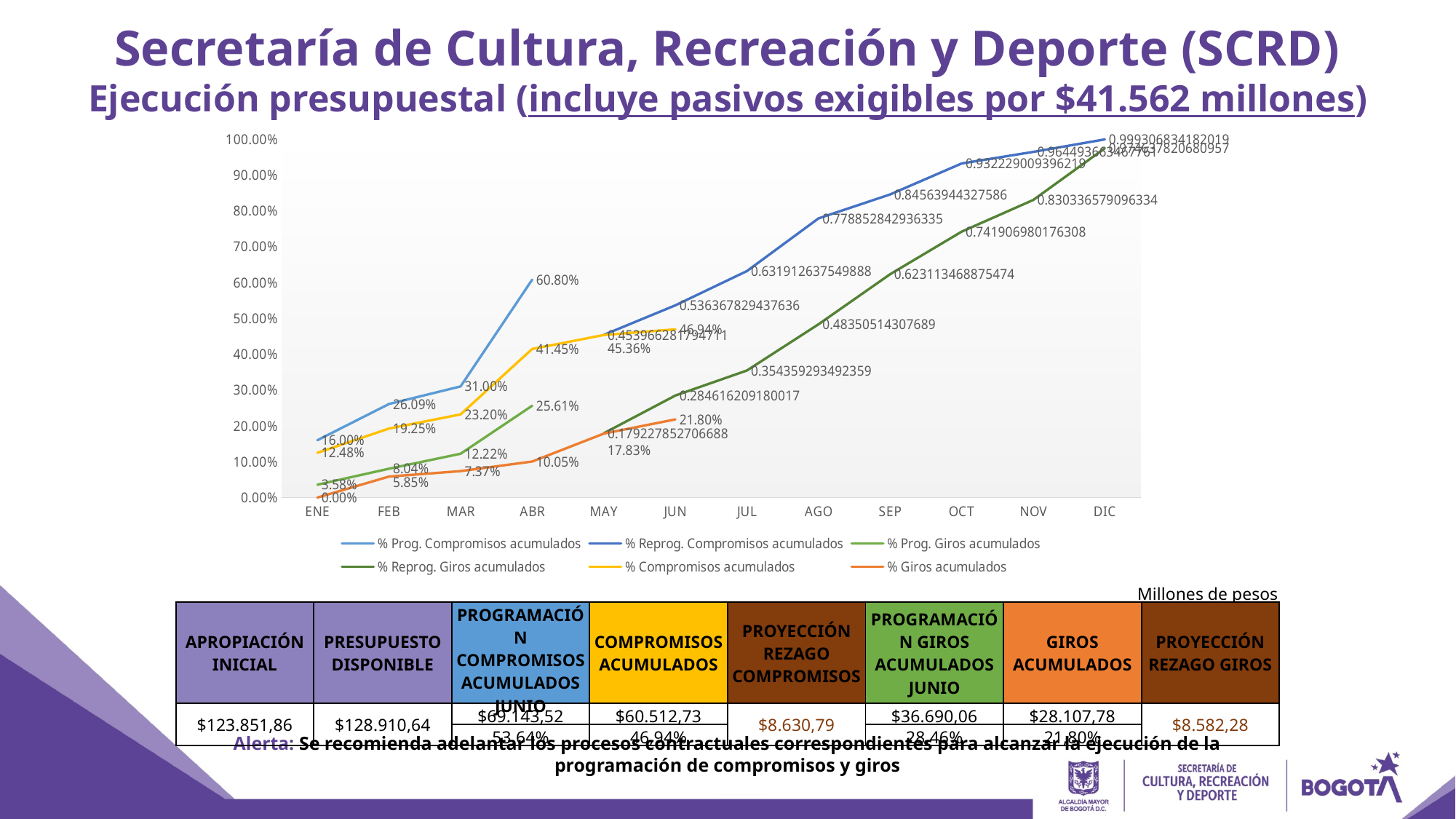
What is the value of % Compromisos acumulados in JUN? 46.94% Does % Compromisos acumulados rise or fall from ENE to JUN? Rise What is the value of % Prog. Compromisos acumulados in ABR? 60.80% In which month does % Prog. Compromisos acumulados reach its highest value? ABR Which is larger in ABR: % Prog. Compromisos acumulados or % Compromisos acumulados? % Prog. Compromisos acumulados What is the value of % Prog. Giros acumulados in FEB? 8.04% What is the value of % Giros acumulados in MAY? 17.83% How many series does the chart legend list? 6 Is the value of % Reprog. Giros acumulados in AGO greater or less than 50.00%? less What is the difference between % Prog. Compromisos acumulados and % Compromisos acumulados in ABR? 19.35% How many months are shown on the x axis of the chart? 12 What kind of chart is shown on the slide? Line chart